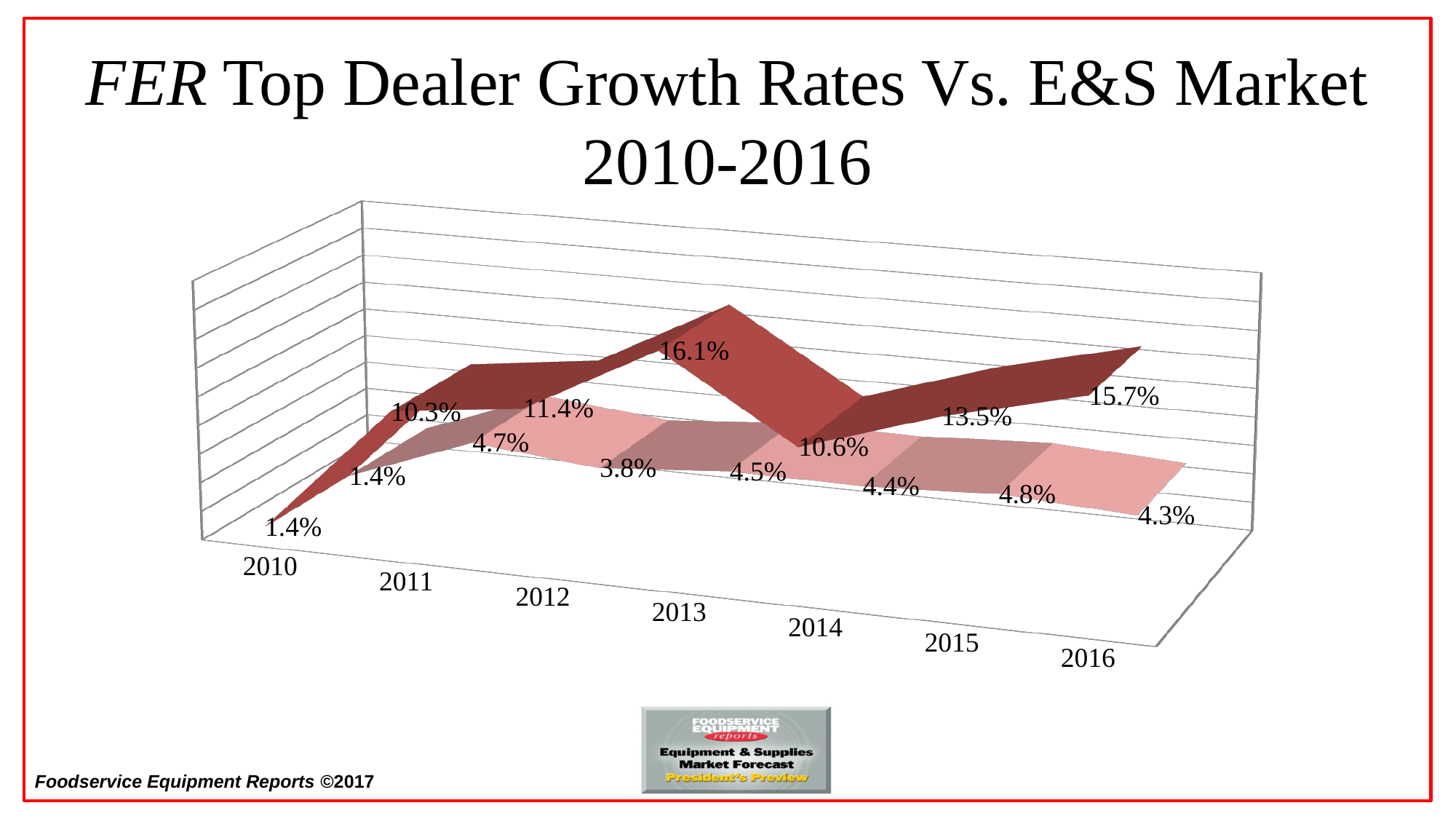
What kind of chart is shown on the slide? 3D line chart Does the darker red (back) series rise or fall from 2013 to 2014? fall What is the value of the lighter pink (front) series for 2012? 3.8% What is the difference between the darker red (back) series and the lighter pink (front) series in 2013? 11.6% What is the value of the darker red (back) series for 2016? 15.7% Which series has the larger value in 2014, the darker red (back) series or the lighter pink (front) series? the darker red (back) series How many years are shown along the x axis of the chart? 7 In which year does the darker red (back) series reach its highest value? 2013 What is the value of the lighter pink (front) series for 2015? 4.8% What is the value of the darker red (back) series for 2013? 16.1% What is the title of the chart slide? FER Top Dealer Growth Rates Vs. E&S Market 2010-2016 In which year does the lighter pink (front) series have its lowest value? 2010